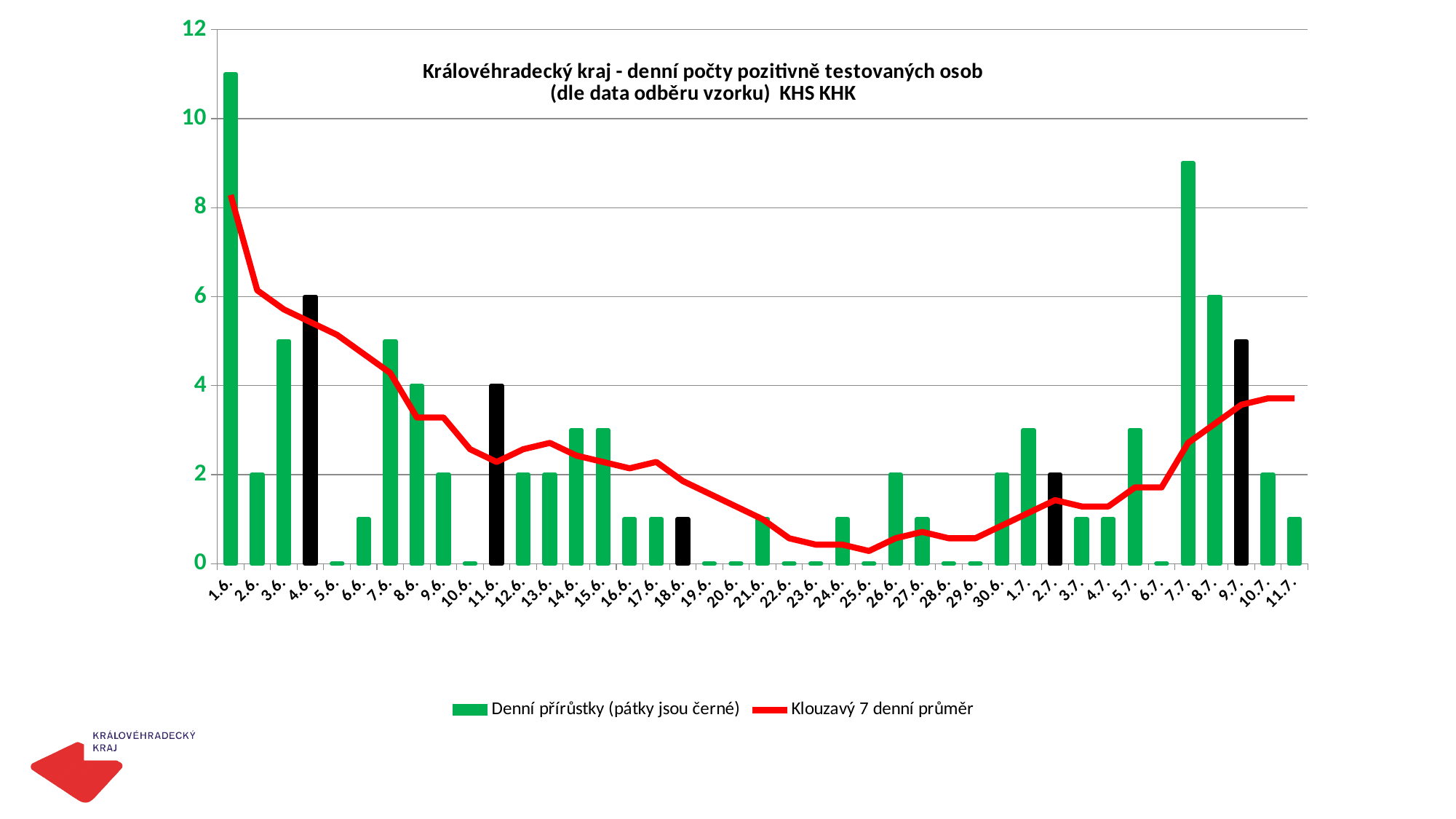
What is the daily count for 25.6.? 0 How many series does the legend list? 2 Which is larger, the daily count for 1.6. or for 7.7.? 1.6. Is the daily count for 7.7. greater or less than 8? greater What is the daily count for 11.6.? 4 What kind of chart is shown on the slide? bar chart with a line Does the 7-day moving average (red line) rise or fall from 1.6. to 25.6.? fall Is the daily count for 1.6. greater or less than 10? greater What is the difference between the daily counts for 4.6. and 11.6.? 2 What is the daily count for 8.7.? 6 What is the daily count for 4.6.? 6 Which date has the highest daily count of positively tested persons? 1.6.